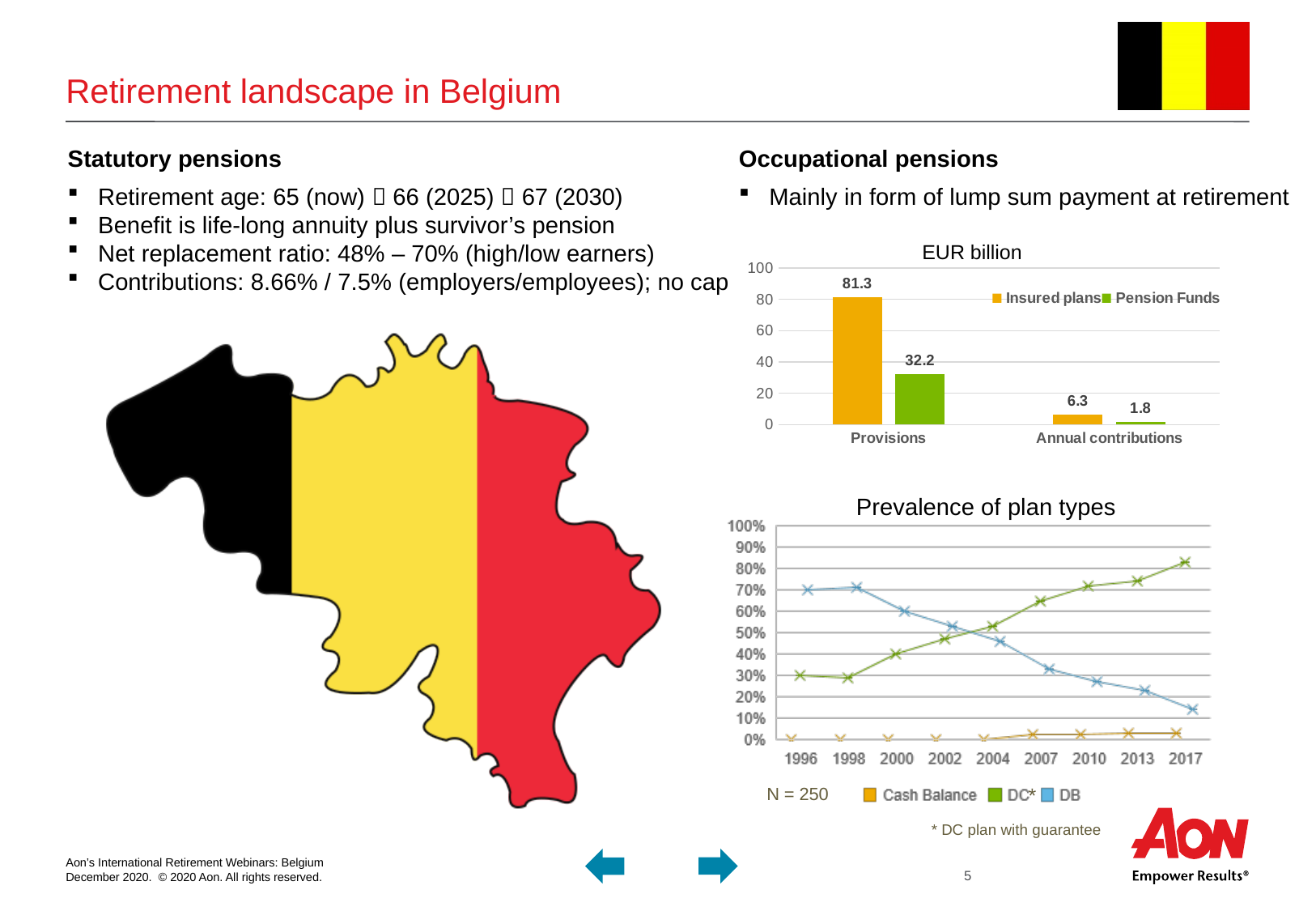
What kind of chart is the EUR billion chart? Bar chart In the EUR billion chart, what is the value for Pension Funds under Provisions? 32.2 In the Prevalence of plan types chart, how many series does the legend list? 3 In the EUR billion chart, how many series does the legend list? 2 In the Prevalence of plan types chart, how many years are shown on the x axis? 9 In the EUR billion chart, what is the difference between Insured plans and Pension Funds under Provisions? 49.1 In the Prevalence of plan types chart, is the value for DC* in 2017 greater or less than 80%? greater In the EUR billion chart, what is the value for Insured plans under Provisions? 81.3 In the EUR billion chart, which bar is the lowest? Pension Funds, Annual contributions In the Prevalence of plan types chart, does the DB series rise or fall from 1996 to 2017? Fall In the EUR billion chart, what is the value for Pension Funds under Annual contributions? 1.8 In the EUR billion chart, what is the value for Insured plans under Annual contributions? 6.3